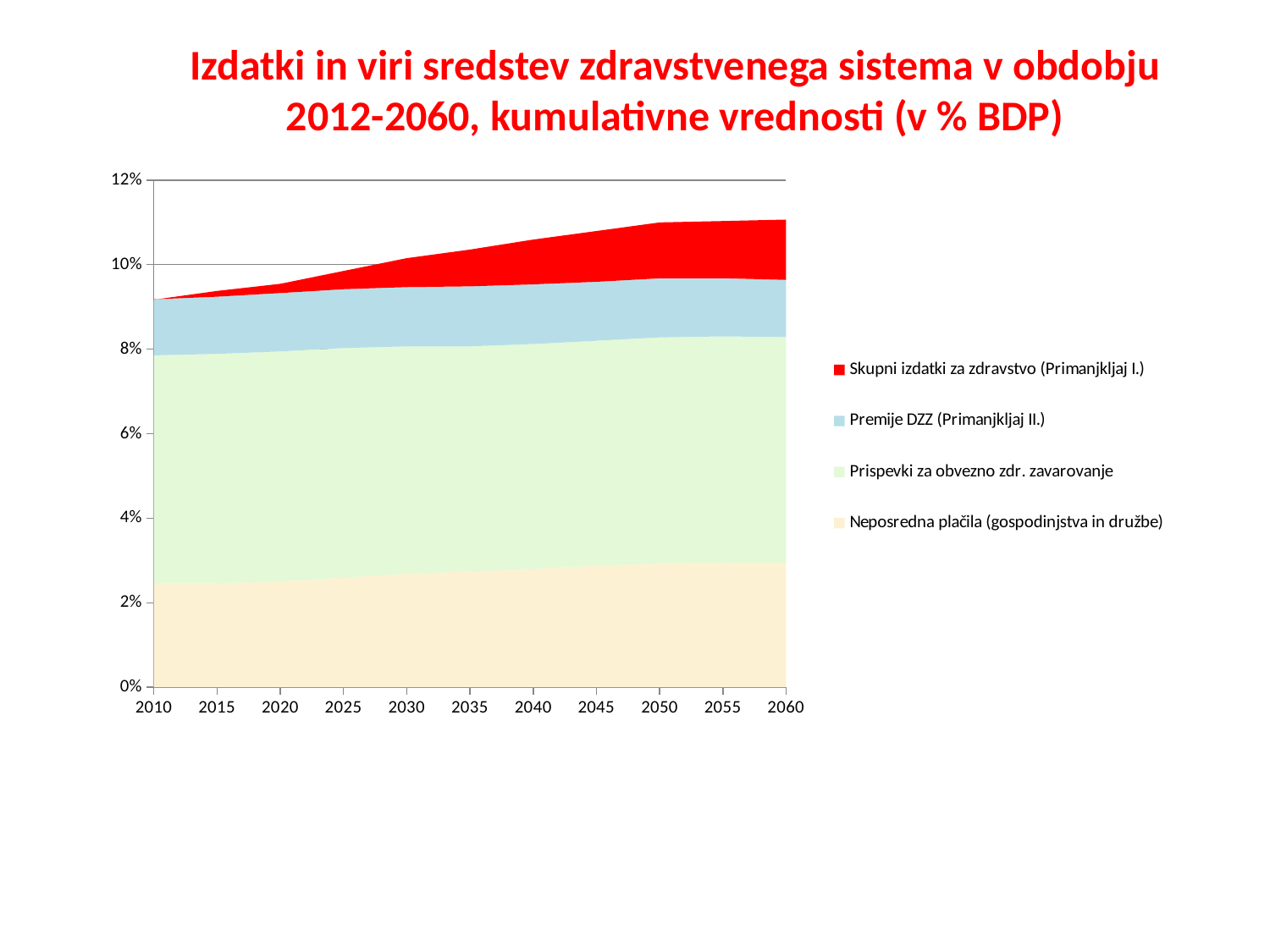
Is the total of all stacked areas in 2060 greater or less than 12%? less What is the title of the slide? Izdatki in viri sredstev zdravstvenega sistema v obdobju 2012-2060, kumulativne vrednosti (v % BDP) What kind of chart is shown on the slide? Stacked area chart Does the total height of the stacked areas rise or fall from 2010 to 2060? Rise Is the total of all stacked areas in 2010 greater or less than 10%? less How many year labels are shown on the x axis? 11 What is the first year shown on the x axis? 2010 Is the total of all stacked areas in 2060 greater or less than 10%? greater How many series does the legend list? 4 Which series is shown in red in the legend? Skupni izdatki za zdravstvo (Primanjkljaj I.) What is the last year shown on the x axis? 2060